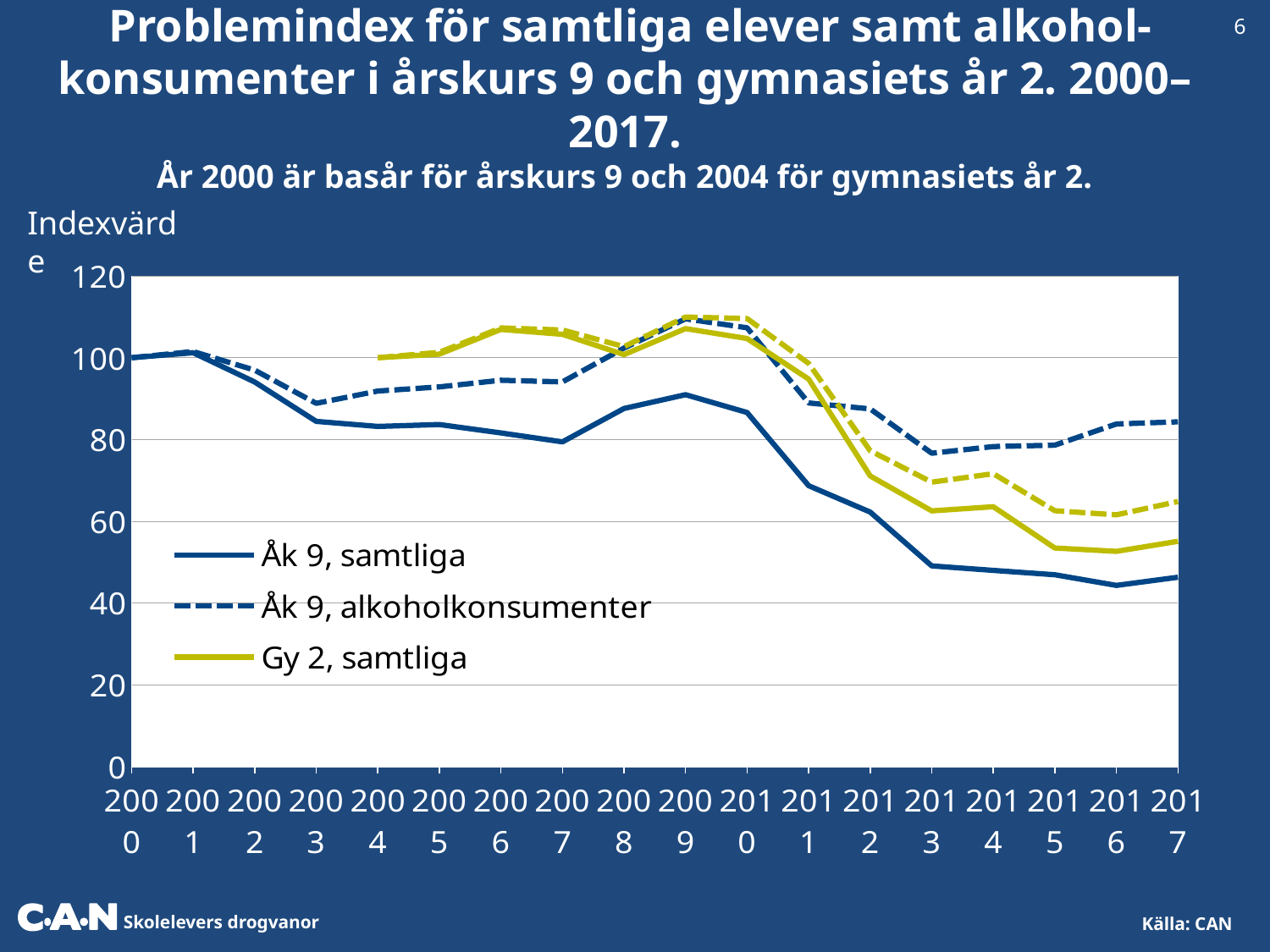
Is the value for Åk 9, samtliga in 2017 greater or less than 60? less Is the value for Åk 9, alkoholkonsumenter in 2017 greater or less than 80? greater What is the index value for Gy 2, samtliga in 2004? 100 What is the index value for Åk 9, samtliga in 2000? 100 Is the value for Gy 2, samtliga in 2006 greater or less than 100? greater In 2013, which is higher: Gy 2, samtliga or Åk 9, samtliga? Gy 2, samtliga How many years are shown on the x axis? 18 What kind of chart is shown on the slide? line chart Which series has the highest value in 2017? Åk 9, alkoholkonsumenter How many series does the legend list? 3 Does the Åk 9, samtliga series rise or fall from 2010 to 2017? fall Which series starts in 2004 rather than 2000? Gy 2, samtliga